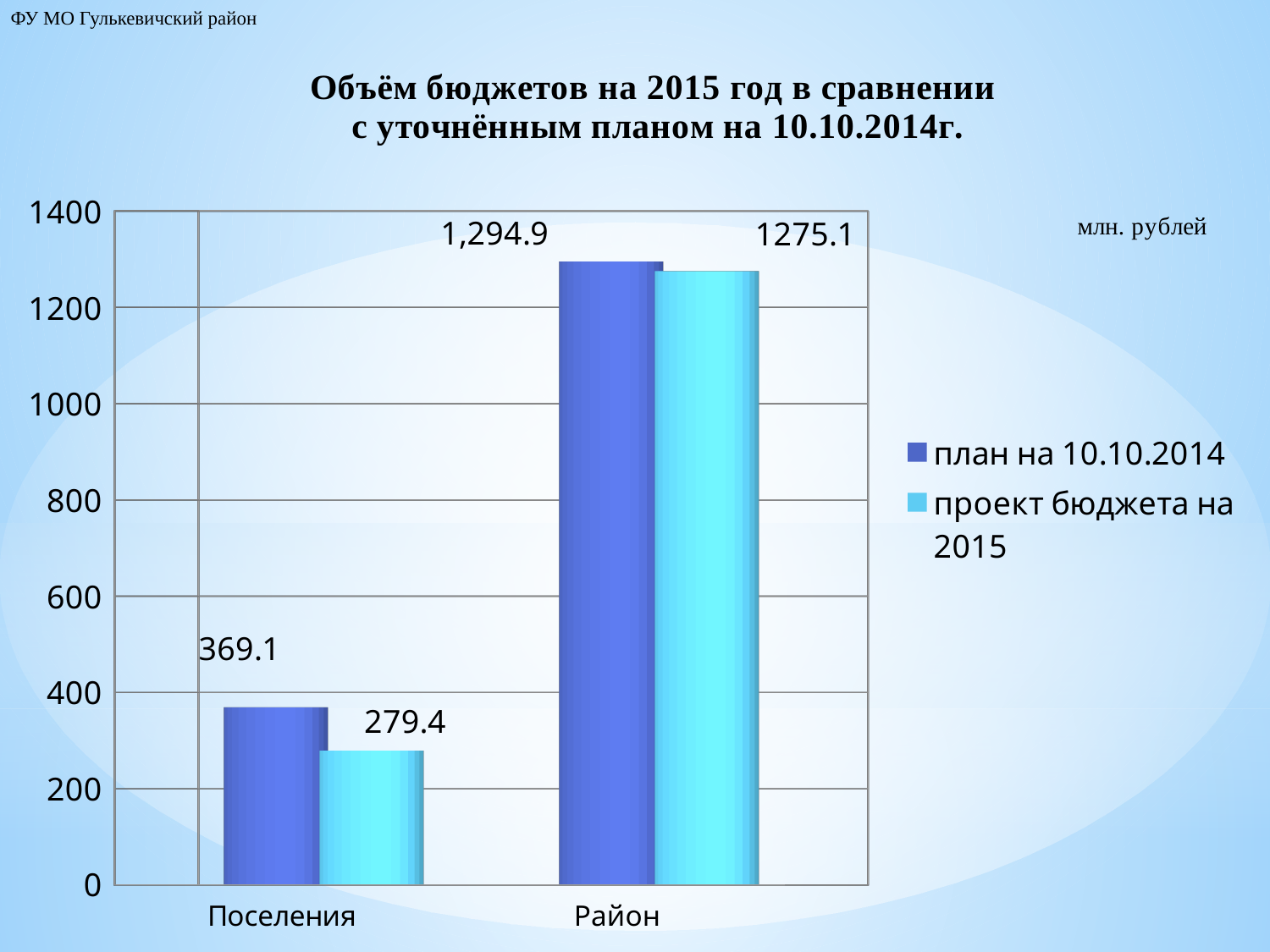
What is the value for Район in the проект бюджета на 2015 series? 1275.1 What is the value for Поселения in the план на 10.10.2014 series? 369.1 What is the difference between the план на 10.10.2014 and проект бюджета на 2015 values for Поселения? 89.7 What is the value for Поселения in the проект бюджета на 2015 series? 279.4 Which category has the lowest value in the проект бюджета на 2015 series? Поселения Which category has the highest value in the план на 10.10.2014 series? Район What kind of chart is shown on the slide? bar chart What is the value for Район in the план на 10.10.2014 series? 1,294.9 How many series does the legend list? 2 For Район, which is larger: план на 10.10.2014 or проект бюджета на 2015? план на 10.10.2014 Is the value for Район in the план на 10.10.2014 series greater or less than 1200? greater How many categories are shown on the x axis? 2